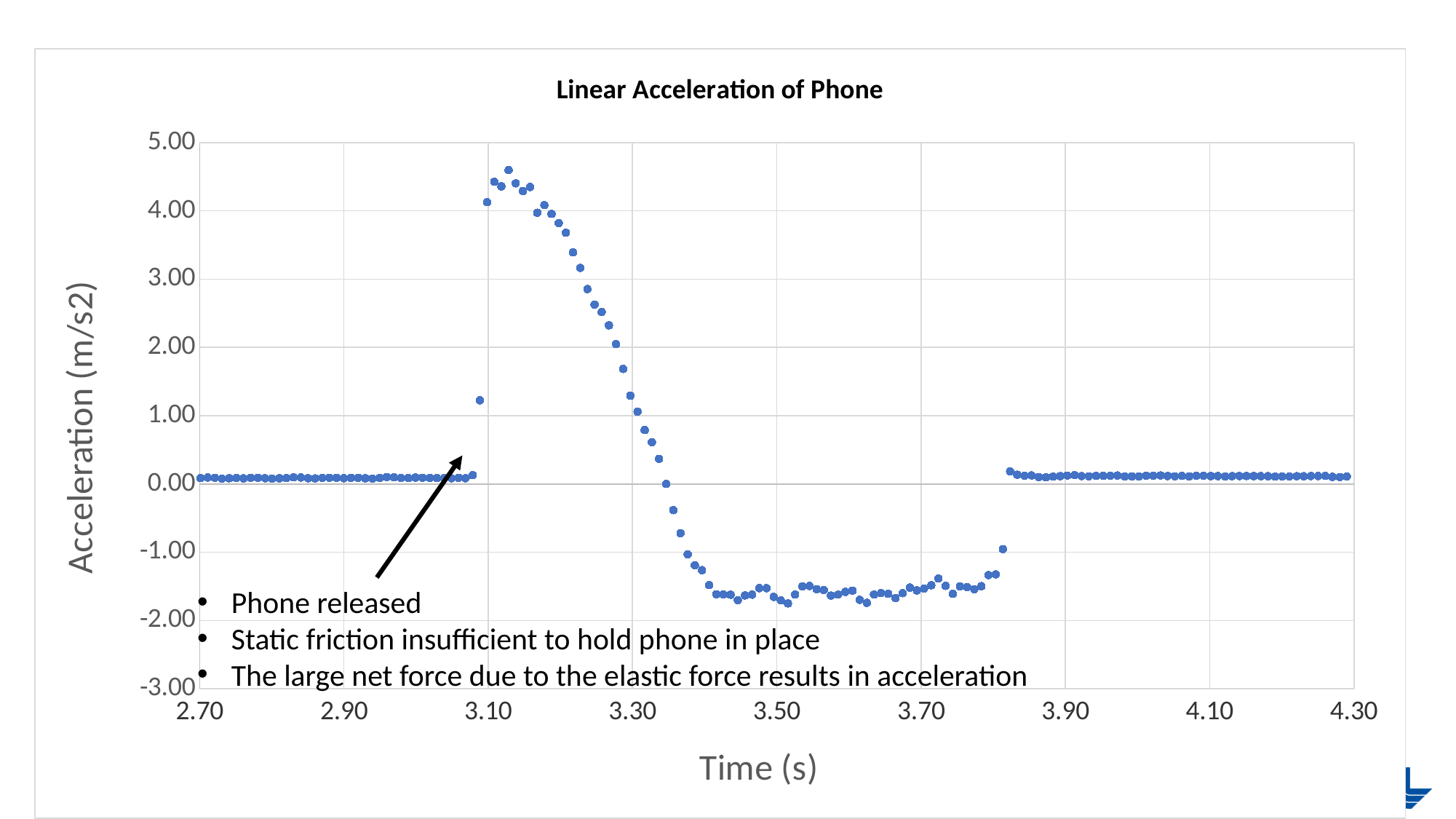
Is the acceleration at time 2.70 s greater or less than 1.00? less Between time 3.10 s and 3.40 s, do the acceleration values rise or fall? fall Between time 3.90 s and 4.30 s, do the acceleration values rise, fall, or stay roughly flat? stay roughly flat Is the lowest acceleration value plotted greater or less than -1.00? less Is the lowest acceleration value plotted greater or less than -2.00? greater Which is larger, the acceleration at time 3.10 s or at time 3.50 s? 3.10 s What is the label of the vertical axis? Acceleration (m/s2) What kind of chart is shown on the slide? scatter chart What is the title of the chart? Linear Acceleration of Phone